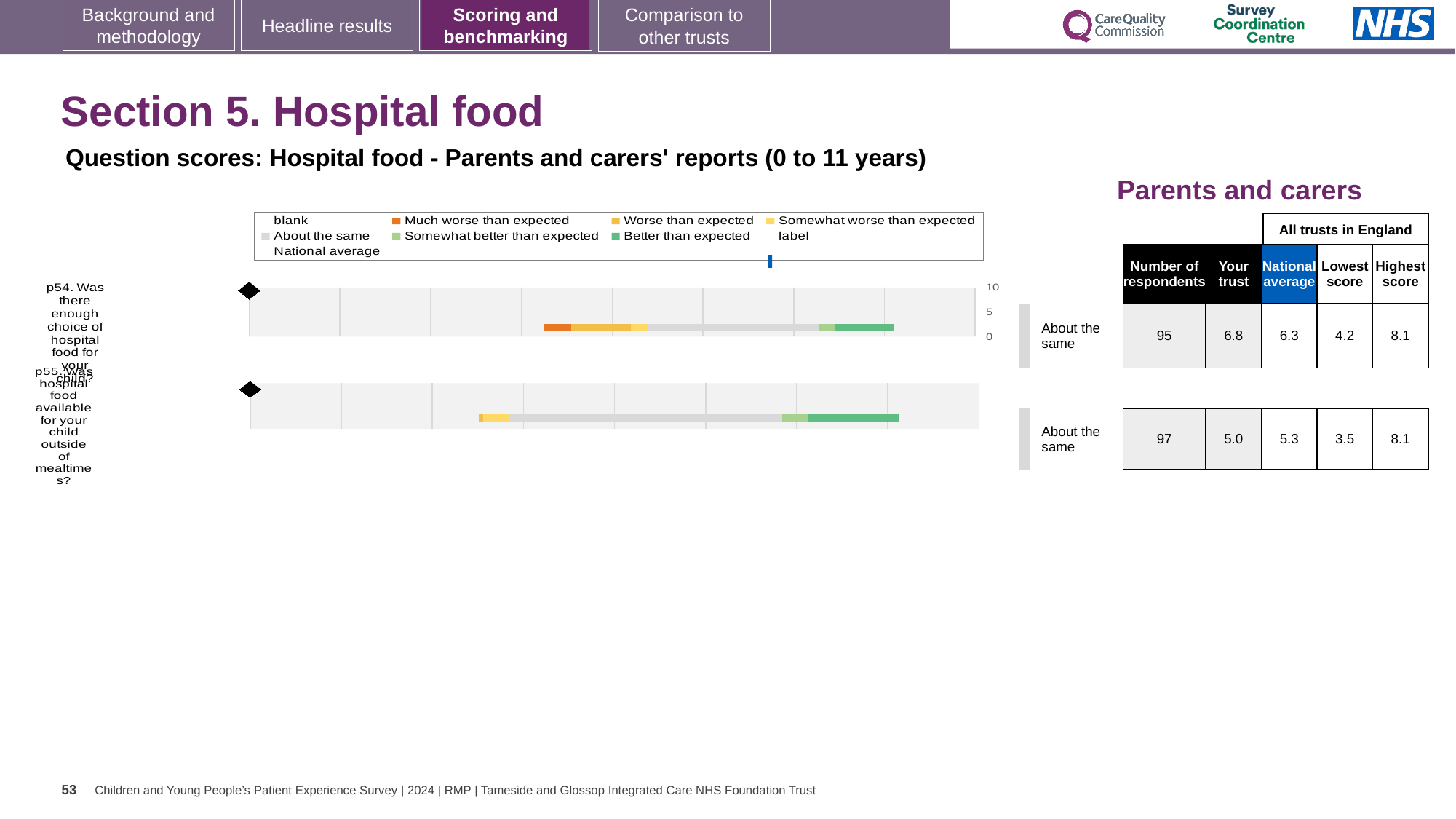
What is the highest value shown on the chart's axis? 10 What is the 'Your trust' score for p54 (enough choice of hospital food)? 6.8 What is the difference between the highest and lowest score across all trusts in England for p55? 4.6 What is the difference between the 'Your trust' score and the national average for p54? 0.5 Which question has the higher 'Your trust' score, p54 or p55? p54 Which legend entry is shown in dark orange? Much worse than expected What kind of chart is used to show the question scores for hospital food? bar chart How many respondents answered p54? 95 How many survey questions are plotted in the hospital food chart? 2 What benchmark category is given for p55? About the same What is the lowest score among all trusts in England for p55? 3.5 What is the national average score for p55 (hospital food available outside of mealtimes)? 5.3